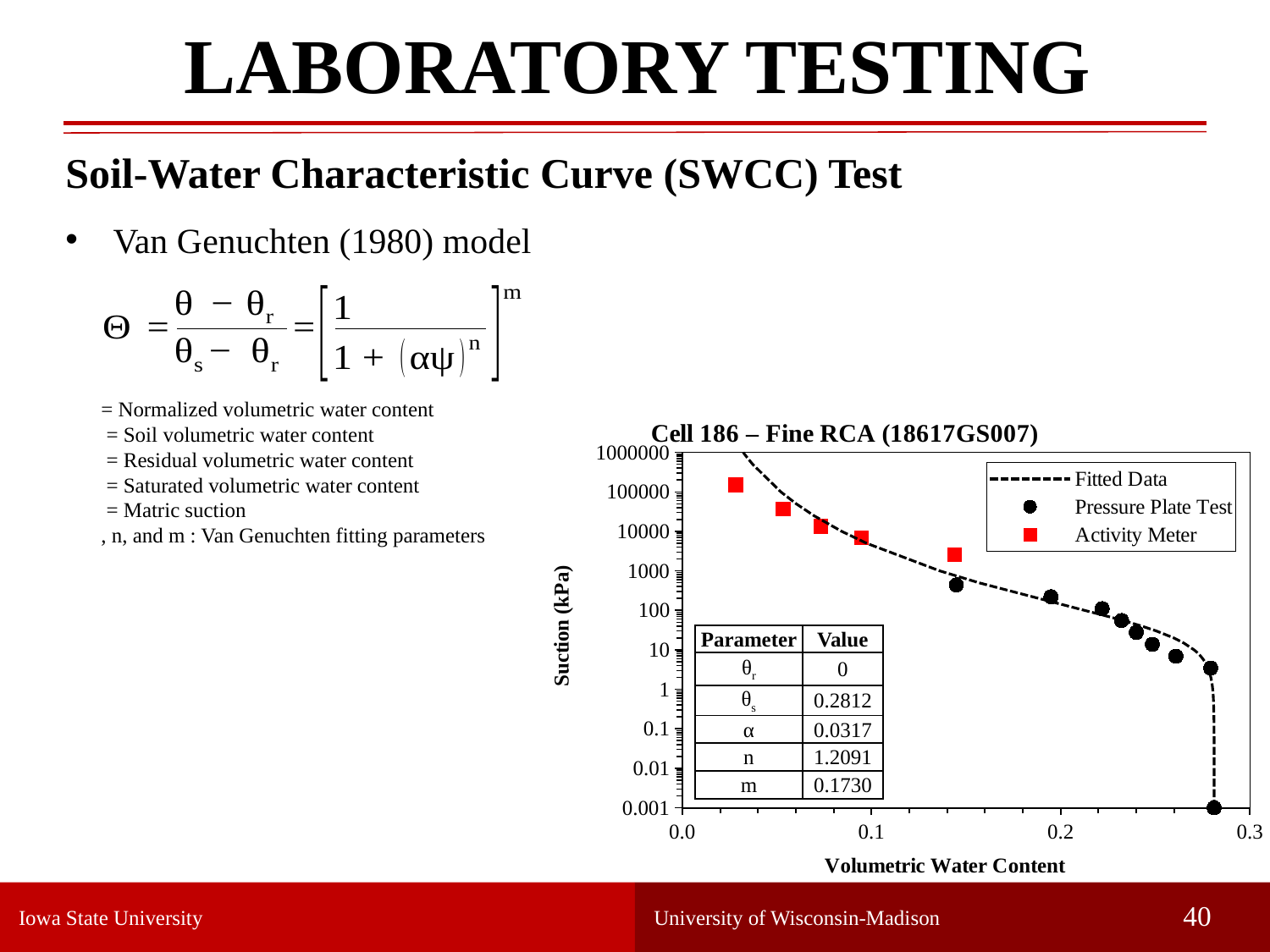
Is the suction of the Pressure Plate Test point at a volumetric water content of about 0.145 greater or less than 1000 kPa? less Is the suction of the leftmost Activity Meter point greater or less than 100000 kPa? greater As volumetric water content increases along the x axis, does the suction rise or fall? Fall Which series is shown with red square markers? Activity Meter What kind of chart is shown on the slide? Scatter plot with a fitted curve According to the parameter table on the chart, what is the value of θs? 0.2812 At a volumetric water content of about 0.145, which series shows the higher suction, Activity Meter or Pressure Plate Test? Activity Meter How many Activity Meter data points are plotted on the chart? 5 Which series contains the point with the lowest suction on the chart? Pressure Plate Test According to the parameter table on the chart, what is the value of n? 1.2091 How many series does the chart legend list? 3 What is the title of the chart? Cell 186 – Fine RCA (18617GS007)